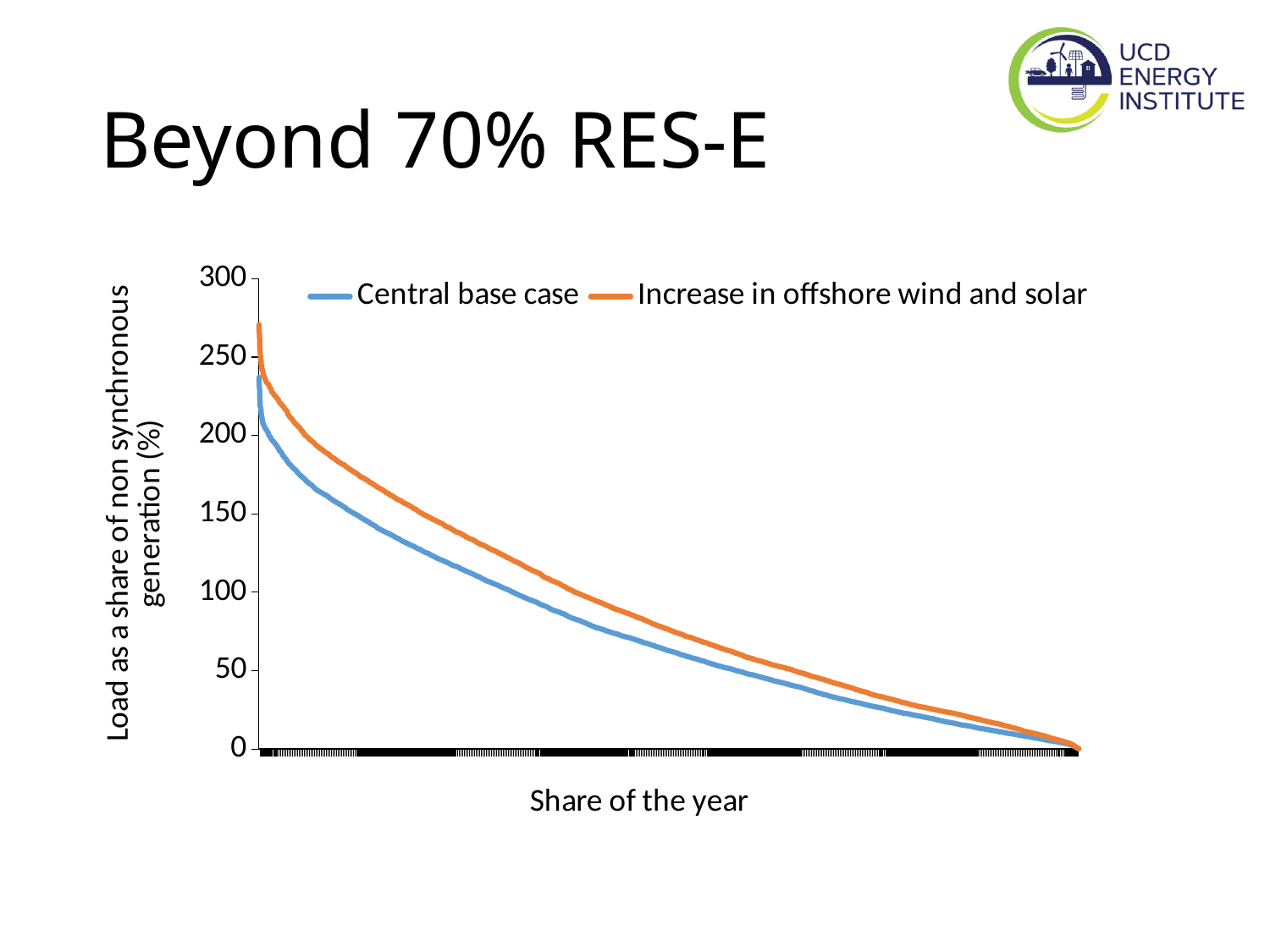
Do the values of the Central base case series rise or fall along the x axis? Fall Is the ending (rightmost) value of the Central base case series greater or less than 50? less Is the starting (leftmost) value of the Central base case series greater or less than 200? greater What are the two series named in the legend? Central base case; Increase in offshore wind and solar What kind of chart is shown on the slide? Line chart Is the starting (leftmost) value of the Increase in offshore wind and solar series greater or less than 250? greater What is the title of the vertical axis? Load as a share of non synchronous generation (%) What is the highest value shown on the vertical axis? 300 Which series lies higher across most of the chart, Central base case or Increase in offshore wind and solar? Increase in offshore wind and solar How many series does the legend list? 2 Do the values of the Increase in offshore wind and solar series rise or fall along the x axis? Fall